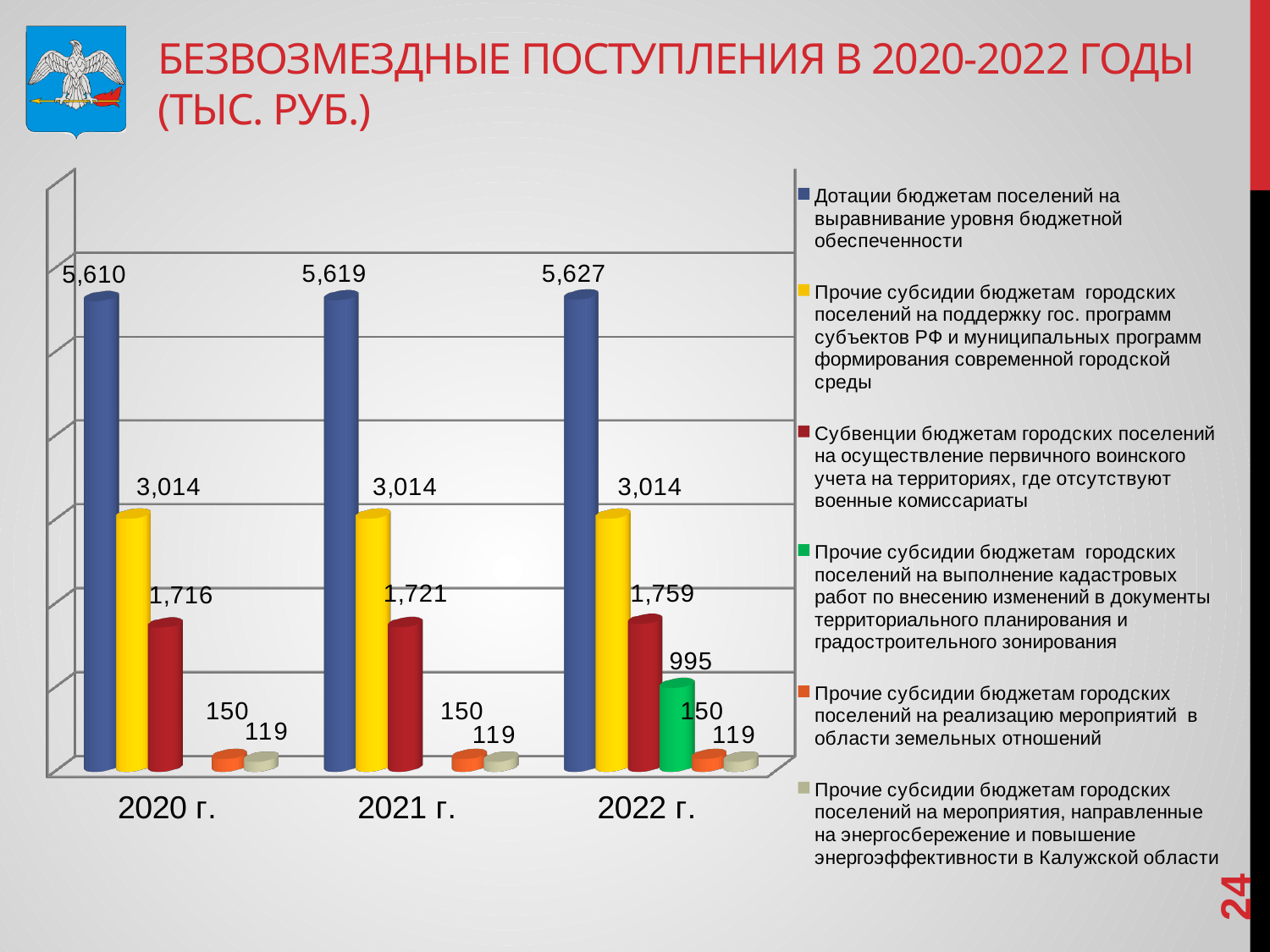
What is the value of the green series (Прочие субсидии на выполнение кадастровых работ) for 2022 г.? 995 Does the value of the blue series (Дотации) rise or fall from 2020 г. to 2022 г.? rise Which is larger: the dark red series value for 2022 г. or for 2020 г.? 2022 г. What is the value of the dark red series (Субвенции бюджетам городских поселений на осуществление первичного воинского учета) for 2021 г.? 1,721 What is the title of the chart on the slide? БЕЗВОЗМЕЗДНЫЕ ПОСТУПЛЕНИЯ В 2020-2022 ГОДЫ (ТЫС. РУБ.) What is the value of the blue series (Дотации бюджетам поселений на выравнивание уровня бюджетной обеспеченности) for 2022 г.? 5,627 How many year categories are shown on the x axis? 3 How many series does the legend list? 6 What type of chart is shown on the slide? bar chart What is the difference between the blue series values for 2022 г. and 2020 г.? 17 Which series has the highest value in 2020 г.? Дотации бюджетам поселений на выравнивание уровня бюджетной обеспеченности